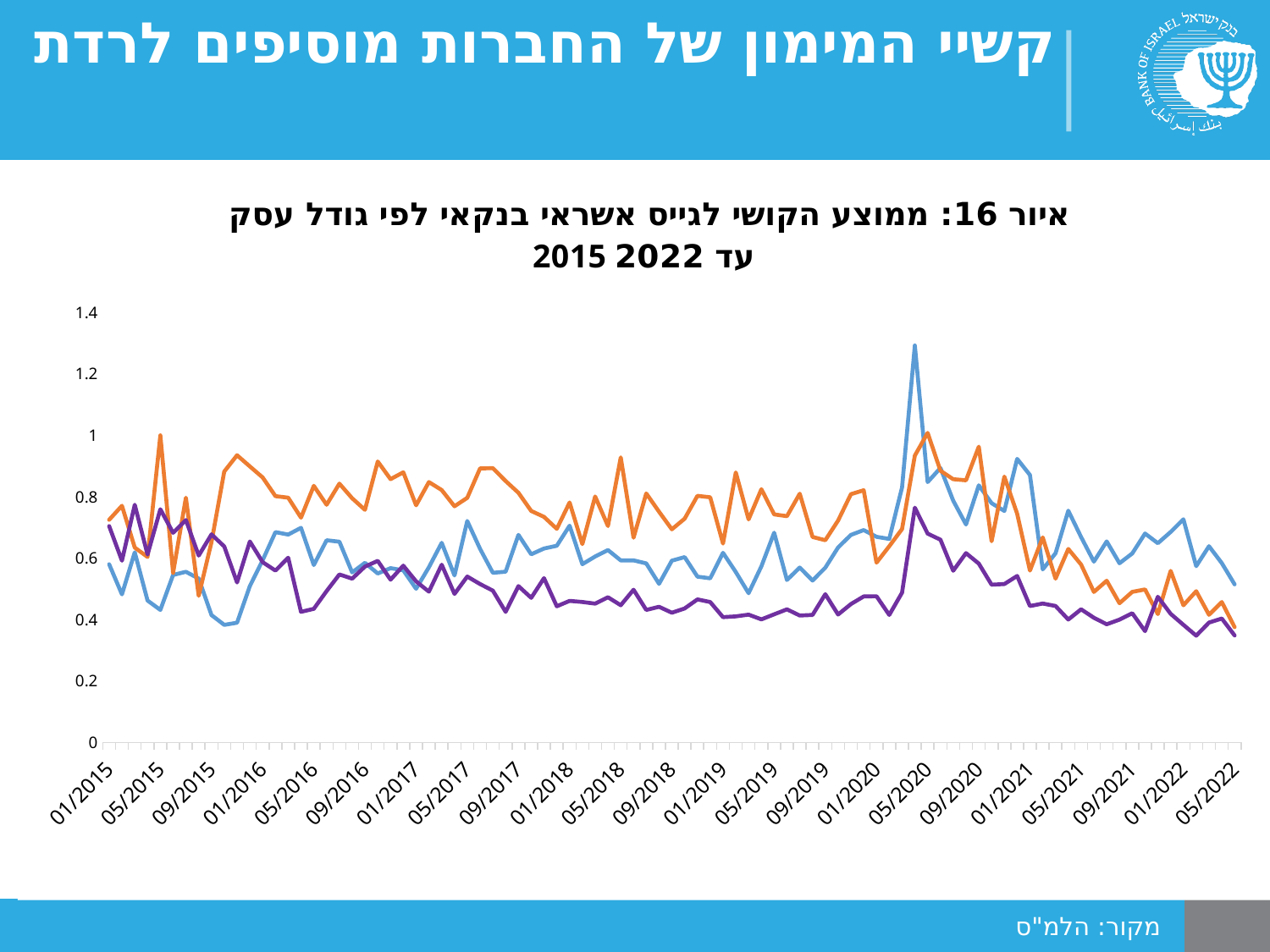
What is the title of the chart? איור 16: ממוצע הקושי לגייס אשראי בנקאי לפי גודל עסק 2015 עד 2022 Does the purple line overall rise or fall from 01/2015 to 05/2022? fall What kind of chart is shown on the slide? line chart Is the value of the orange line at 01/2016 greater or less than 0.8? greater Which line reaches the highest value anywhere on the chart? the blue line At 01/2019, which is larger: the orange line or the purple line? the orange line What source is cited at the bottom of the slide? הלמ"ס Which line is the lowest of the three for most of 2017 through 2019? the purple line Is the peak value of the blue line around 05/2020 greater or less than 1.2? greater How many lines are plotted on the chart? 3 Is the value of the purple line at 05/2022 greater or less than 0.4? less